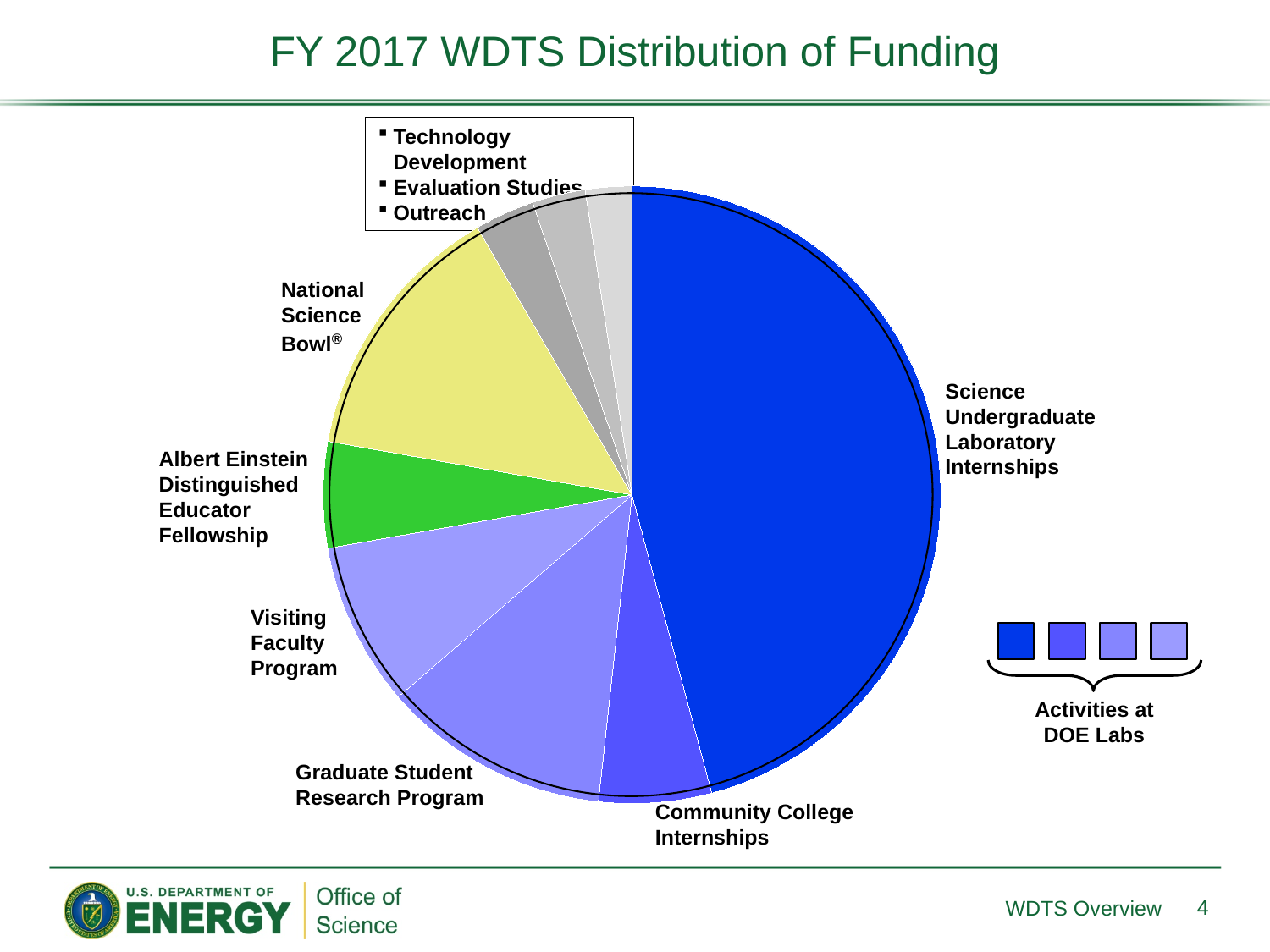
Which is larger: the slice for Graduate Student Research Program or the slice for Community College Internships? Graduate Student Research Program What is the title of the chart? FY 2017 WDTS Distribution of Funding Does the Science Undergraduate Laboratory Internships slice take up more or less than half of the pie? less What kind of chart is shown on the slide? pie chart How many programs are grouped under the label 'Activities at DOE Labs'? 4 Which is larger: the slice for Visiting Faculty Program or the slice for Outreach? Visiting Faculty Program Which is larger: the slice for National Science Bowl or the slice for Albert Einstein Distinguished Educator Fellowship? National Science Bowl How many slices does the pie chart have? 9 Which program receives the largest share of funding in the pie chart? Science Undergraduate Laboratory Internships